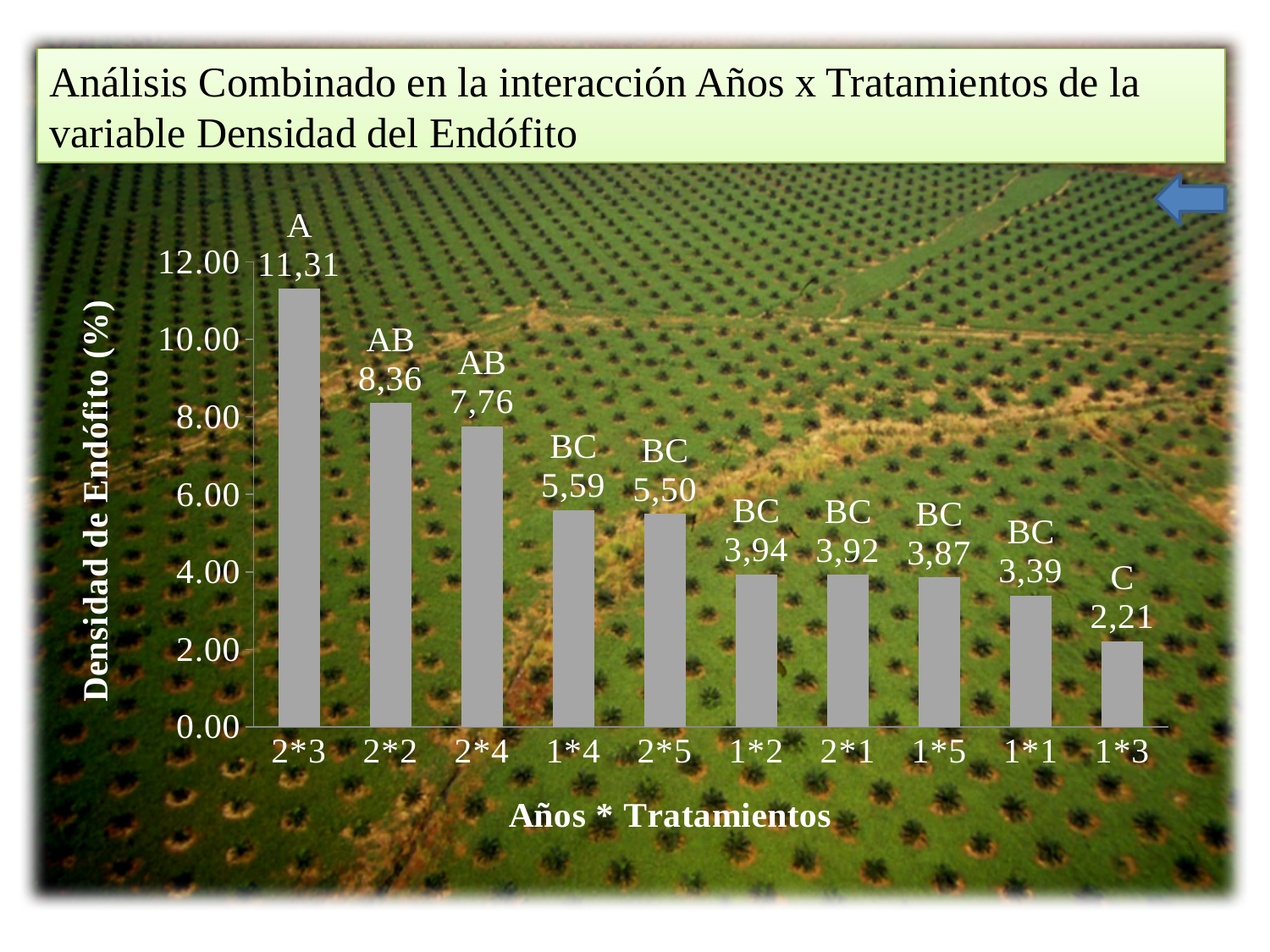
Is the value for 2*3 greater or less than 10.00? greater What is the label of the y axis? Densidad de Endófito (%) What is the value for 1*4? 5,59 What is the value for 1*1? 3,39 Which is larger, the value for 2*2 or the value for 2*5? 2*2 What is the difference between the values for 2*3 and 2*2? 2,95 What is the difference between the values for 1*1 and 1*3? 1,18 Which category has the lowest value? 1*3 What kind of chart is shown on the slide? bar chart How many categories are shown on the x axis? 10 Which category has the highest value? 2*3 What is the value for 2*3? 11,31